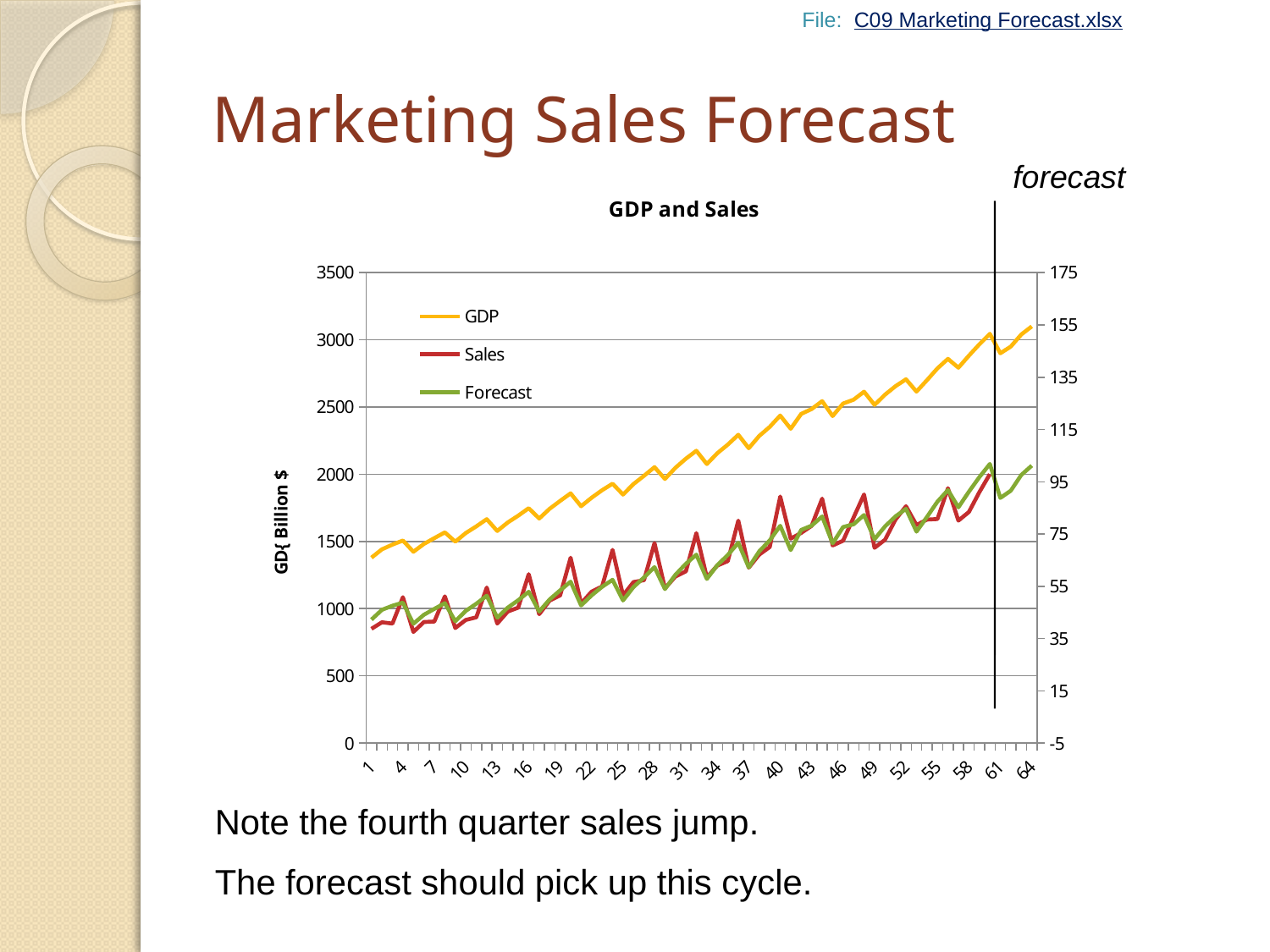
What kind of chart is shown on the slide? line chart Is the GDP value at period 64 greater or less than 2500 on the left axis? greater How many series does the chart legend list? 3 Does the GDP series rise or fall along the x axis? rise Is the GDP value at period 1 greater or less than 2000 on the left axis? less Which series are listed in the chart legend? GDP, Sales, Forecast What is the highest value shown on the left vertical axis? 3500 Is the GDP value at period 1 greater or less than 1000 on the left axis? greater Does the Sales series generally rise or fall along the x axis? rise What is the title of the chart? GDP and Sales How many periods are shown on the x axis? 64